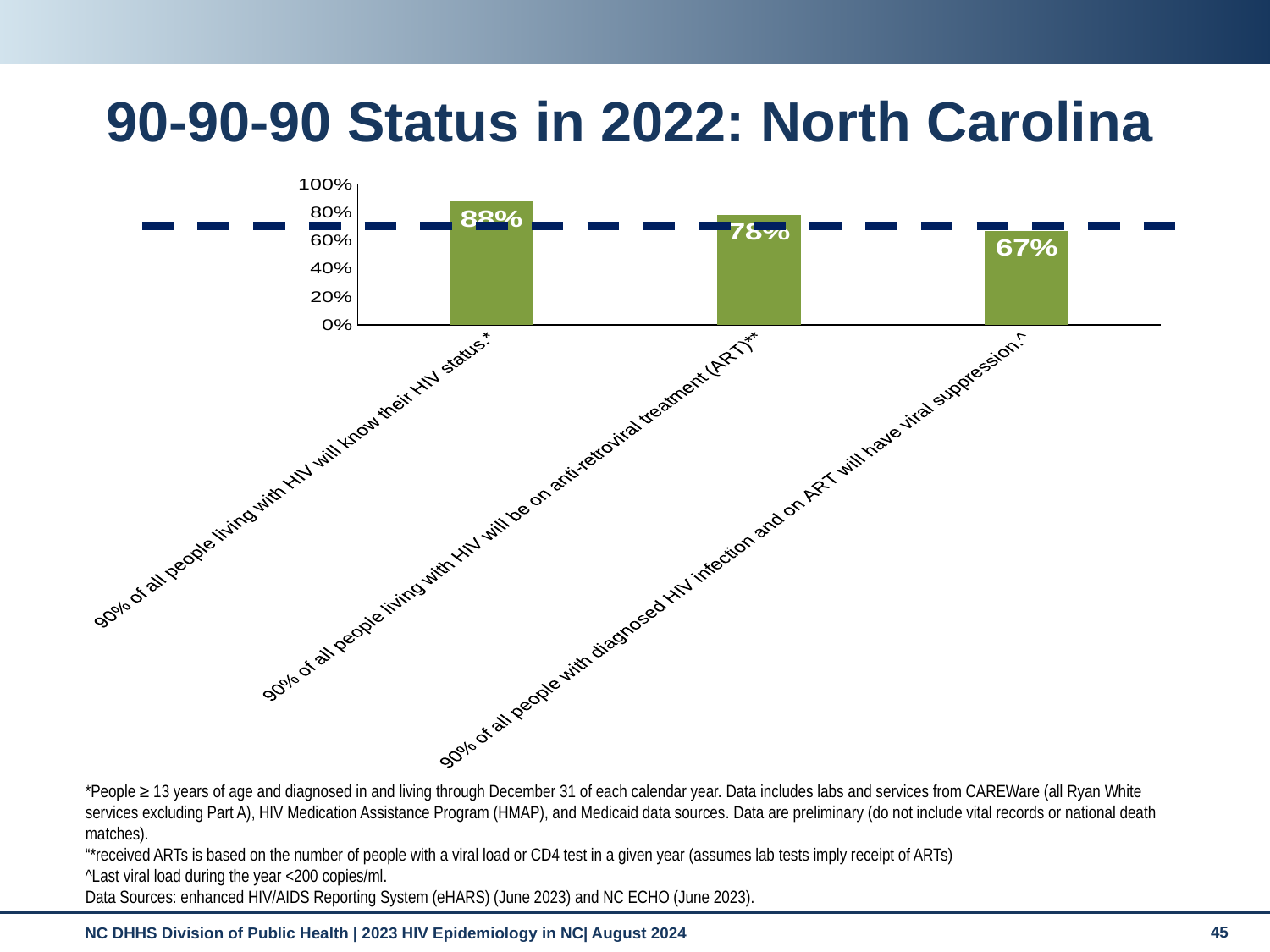
What kind of chart is shown on the slide? Bar chart Which is larger: the value for being on anti-retroviral treatment (ART) or the value for viral suppression? Being on anti-retroviral treatment (ART) What is the value for the bar labelled "90% of all people living with HIV will be on anti-retroviral treatment (ART)"? 78% What is the value for the bar labelled "90% of all people with diagnosed HIV infection and on ART will have viral suppression"? 67% Do the values rise or fall from left to right across the bars? Fall Which category has the highest value? 90% of all people living with HIV will know their HIV status How many bars are plotted in the chart? 3 What is the difference between the value for knowing HIV status and the value for viral suppression? 21% Is the value for viral suppression greater or less than 80%? less What is the difference between the value for knowing HIV status and the value for being on anti-retroviral treatment (ART)? 10% Which category has the lowest value? 90% of all people with diagnosed HIV infection and on ART will have viral suppression What is the value for the bar labelled "90% of all people living with HIV will know their HIV status"? 88%